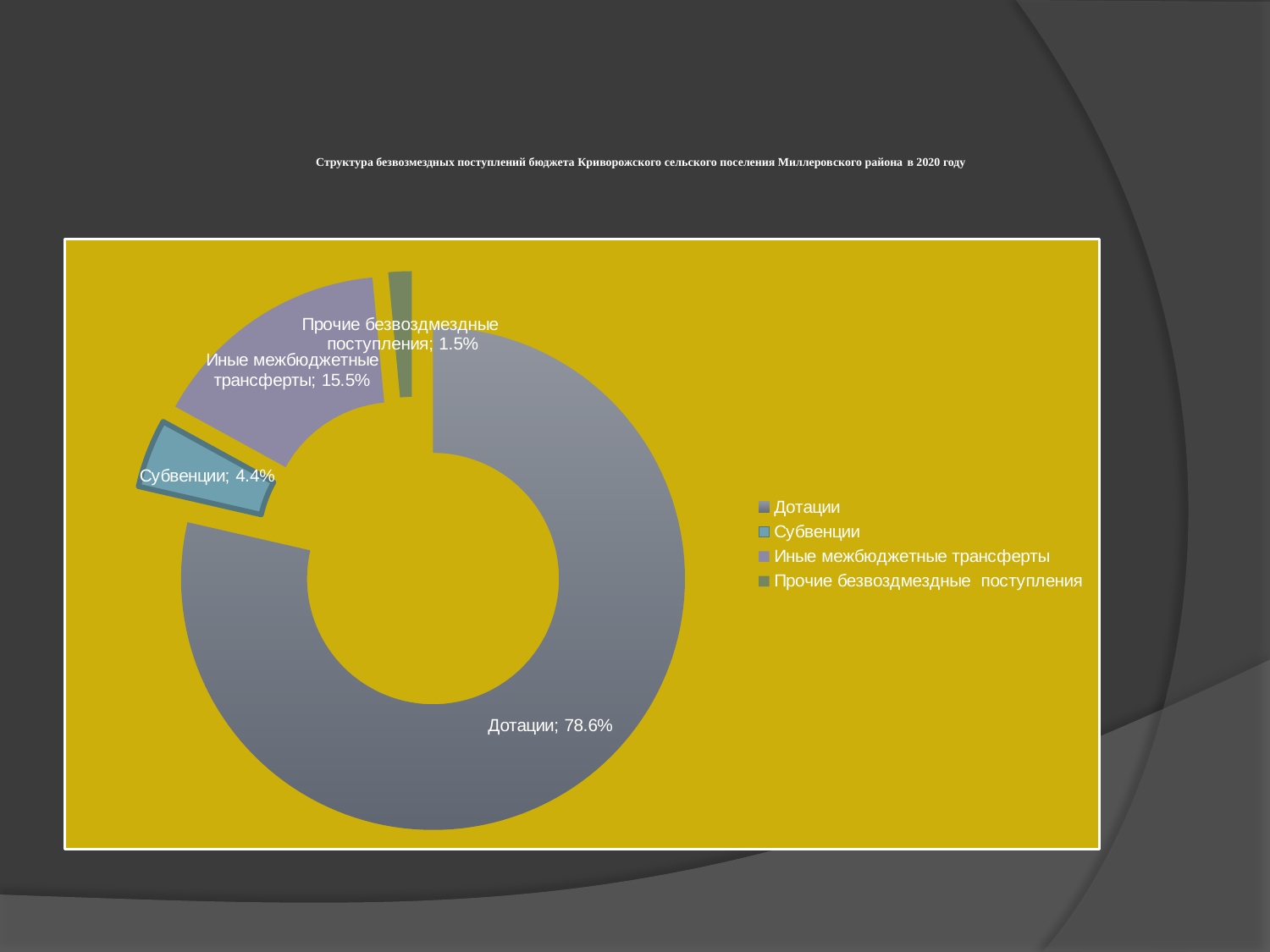
What is the value shown for Субвенции? 4.4% Which category has the smallest share? Прочие безвозмездные поступления What is the difference between the shares of Иные межбюджетные трансферты and Субвенции? 11.1% What colour is the Дотации segment? Grey What is the value shown for Иные межбюджетные трансферты? 15.5% What kind of chart is shown on the slide? Doughnut (pie) chart What share of the chart does Дотации represent? 78.6% Which category has the largest share? Дотации Which is larger, the share of Субвенции or the share of Прочие безвозмездные поступления? Субвенции How many entries does the legend list? 4 How many categories are shown in the chart? 4 What is the value shown for Прочие безвозмездные поступления? 1.5%